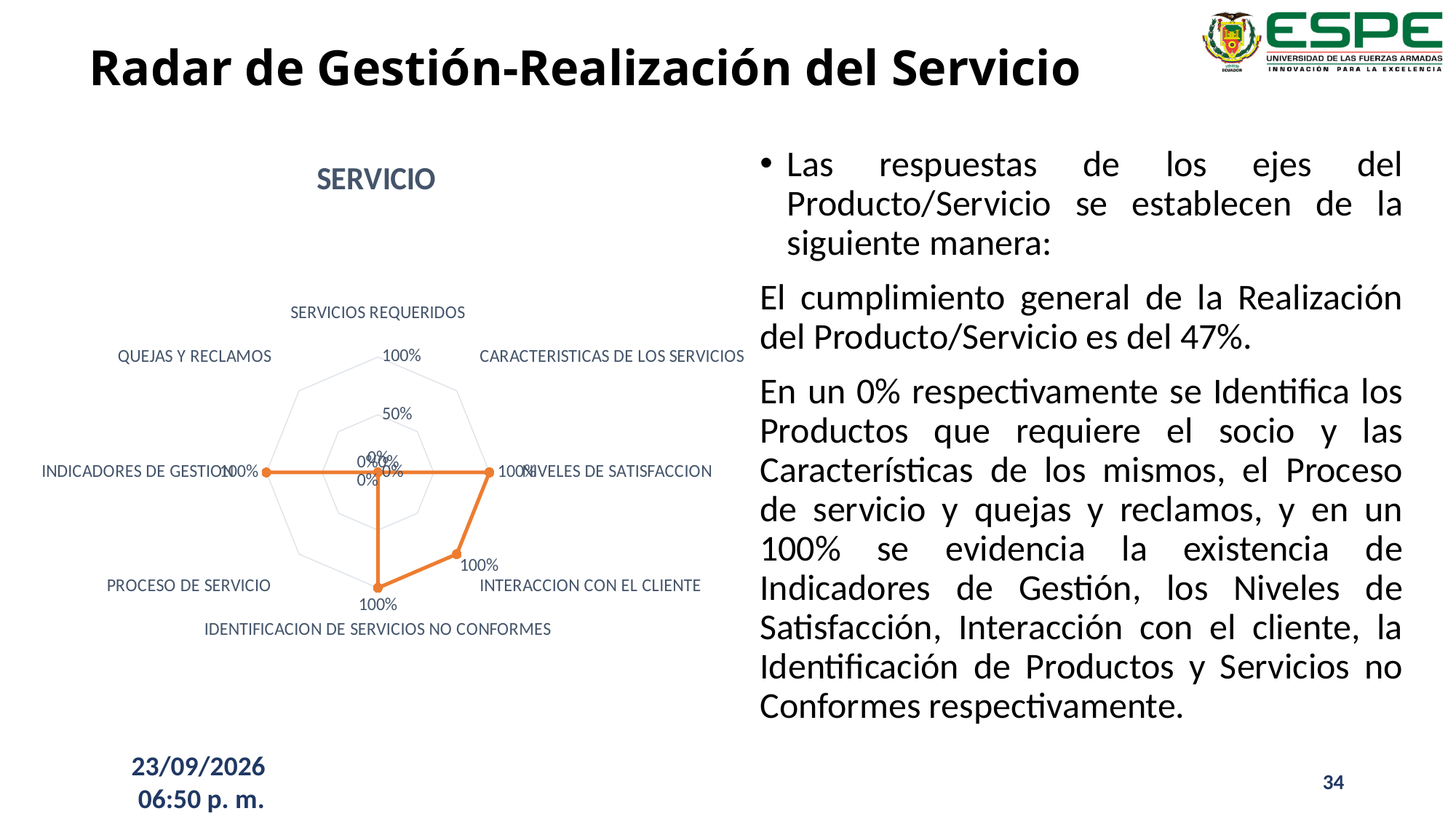
What is the title of the chart? SERVICIO What is the value for INDICADORES DE GESTION? 100% What is the value for QUEJAS Y RECLAMOS? 0% Which is larger, the value for INDICADORES DE GESTION or the value for SERVICIOS REQUERIDOS? INDICADORES DE GESTION What type of chart is shown on the slide? Radar chart What is the value for IDENTIFICACION DE SERVICIOS NO CONFORMES? 100% How many categories (axes) does the radar chart have? 8 What is the maximum value shown on the radar chart's scale? 100% What is the value for INTERACCION CON EL CLIENTE? 100% What is the value for NIVELES DE SATISFACCION? 100% What is the value for PROCESO DE SERVICIO? 0% What is the difference between the value for NIVELES DE SATISFACCION and the value for CARACTERISTICAS DE LOS SERVICIOS? 100%